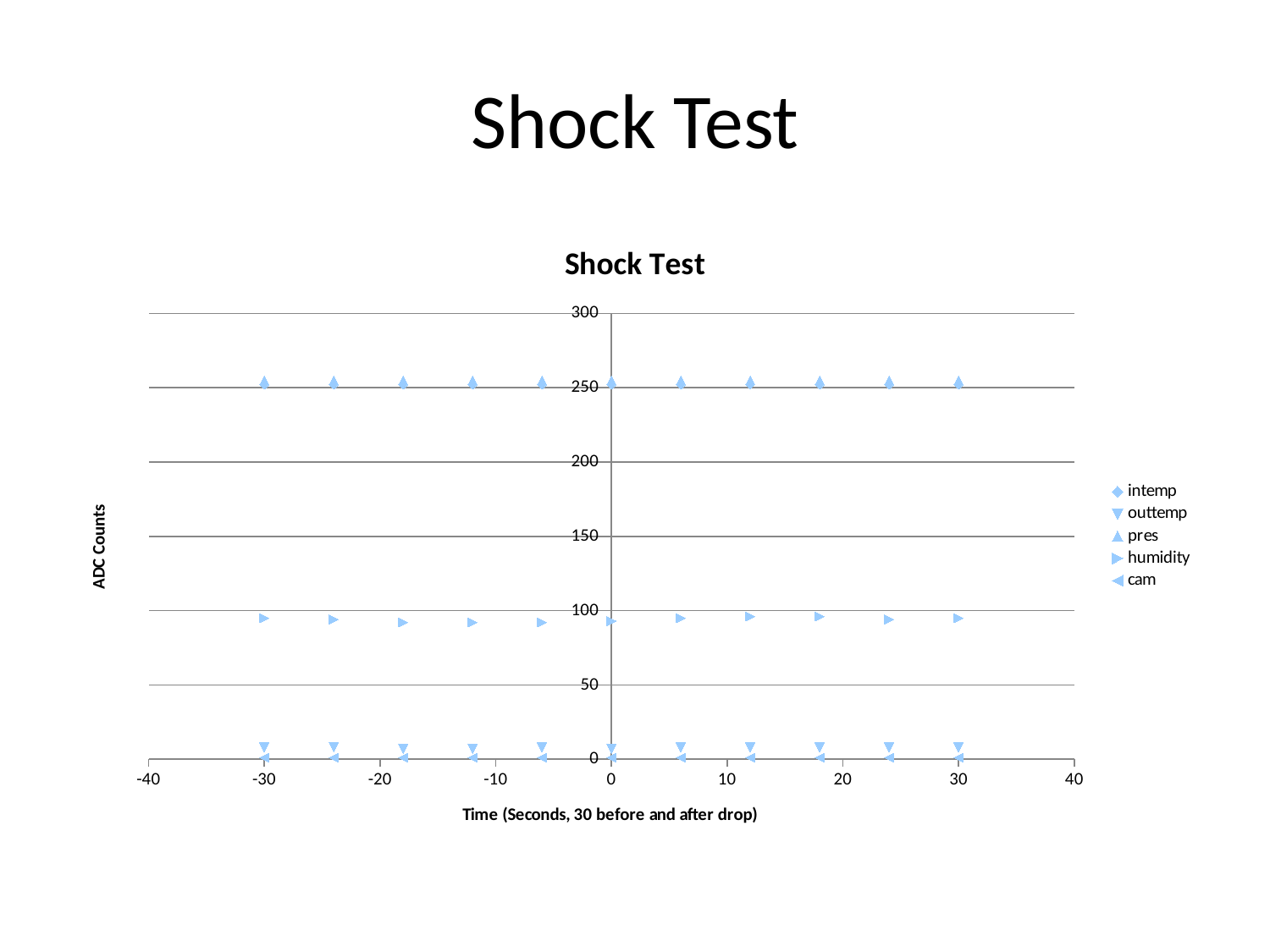
Is the value for humidity at time 0 greater or less than 100? less How many series does the legend list? 5 Is the value for outtemp at time -30 greater or less than 50? less What is the label of the vertical axis? ADC Counts Is the value for humidity at time 30 greater or less than 50? greater How many data points are plotted for the pres series? 11 Which is larger at time -30: the value for humidity or the value for outtemp? humidity Do the pres values rise, fall, or stay roughly flat across the time axis? stay roughly flat What kind of chart is shown on the slide? scatter chart Which series has the highest ADC Counts values? pres